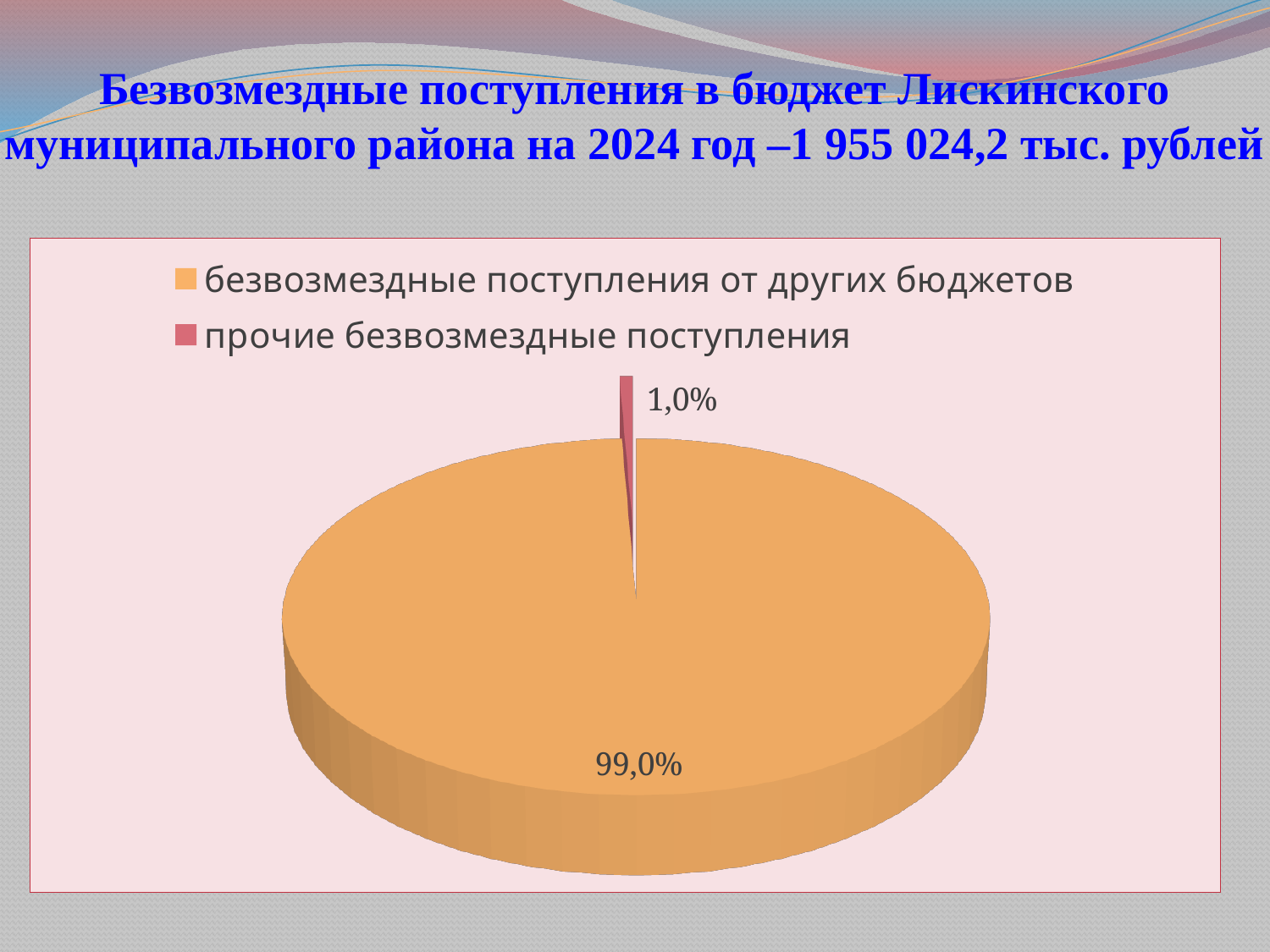
What colour is the slice for 'прочие безвозмездные поступления'? red What share of the pie does 'безвозмездные поступления от других бюджетов' have? 99,0% What is the difference in percentage points between the share of 'безвозмездные поступления от других бюджетов' and 'прочие безвозмездные поступления'? 98,0% What share of the pie does 'прочие безвозмездные поступления' have? 1,0% Which category has the largest slice of the pie? безвозмездные поступления от других бюджетов Which category has the smallest slice of the pie? прочие безвозмездные поступления How many entries does the legend list? 2 What kind of chart is shown on the slide? pie chart Which is larger: the share of 'безвозмездные поступления от других бюджетов' or the share of 'прочие безвозмездные поступления'? безвозмездные поступления от других бюджетов What total amount in thousand rubles is stated in the slide title for 2024? 1 955 024,2 тыс. рублей How many categories does the pie chart show? 2